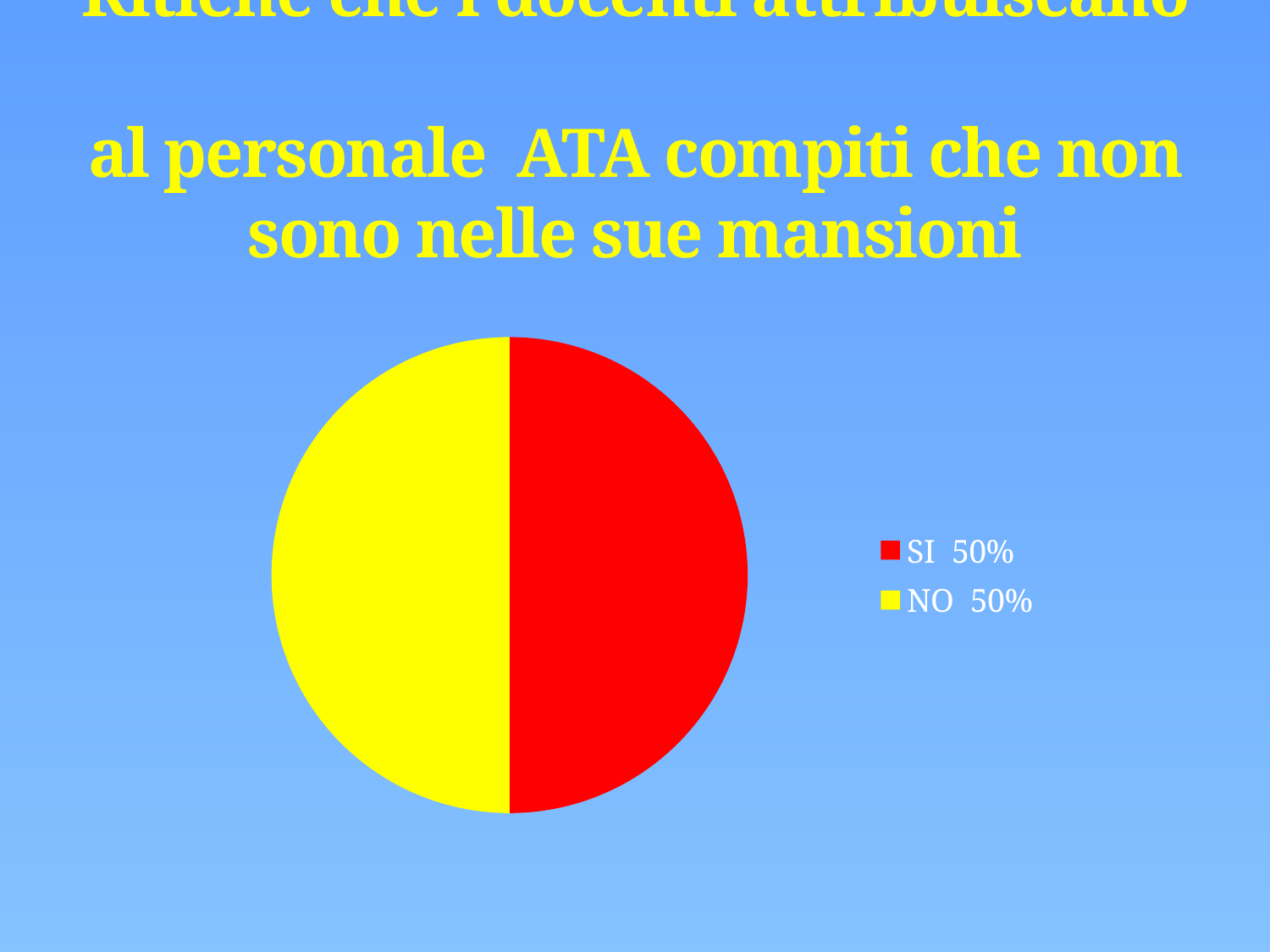
What share of the pie does the NO slice represent? 50% Is the share for SI greater or less than 75%? less What is the difference between the SI and NO percentages? 0% What is the percentage shown in the legend for SI? 50% What colour is the NO slice of the pie chart? yellow What colour is the SI slice of the pie chart? red What share of the pie does the SI slice represent? 50% How many slices does the pie chart have? 2 What do the SI and NO shares add up to? 100% What is the percentage shown in the legend for NO? 50% What kind of chart is shown on the slide? pie chart Is the share for NO greater or less than 25%? greater